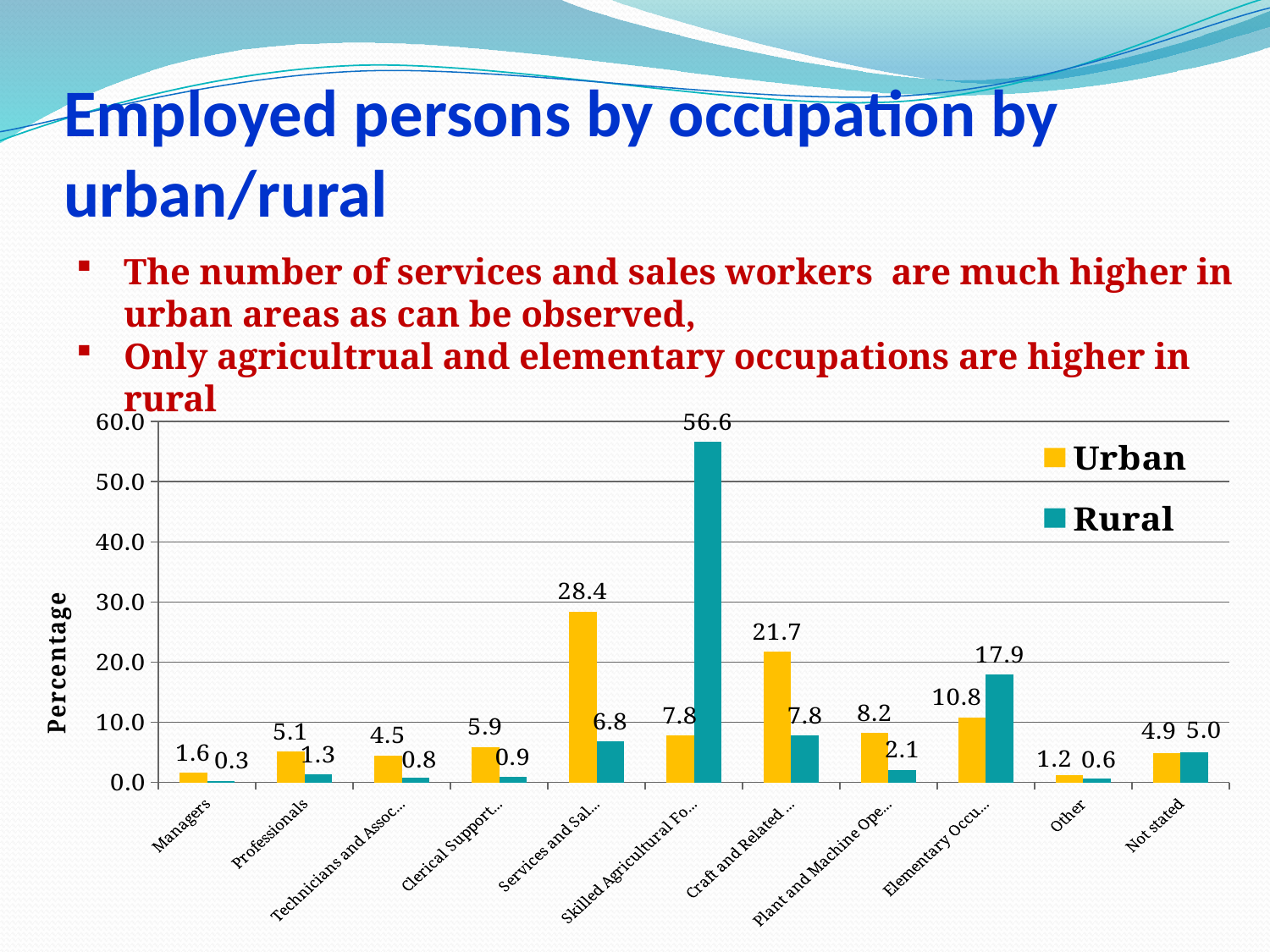
What is the difference between the Urban and Rural values for Other? 0.6 What is the Urban value for Managers? 1.6 What is the label of the y axis? Percentage How many occupation categories are shown on the x axis? 11 Which category has the lowest Rural value? Managers Which category has the highest Urban value? Services and Sales What kind of chart is shown on the slide? Bar chart Which is larger for Professionals, the Urban value or the Rural value? Urban Which category has the highest Rural value? Skilled Agricultural What is the Rural value for Professionals? 1.3 How many series does the legend list? 2 What is the Rural value for Not stated? 5.0